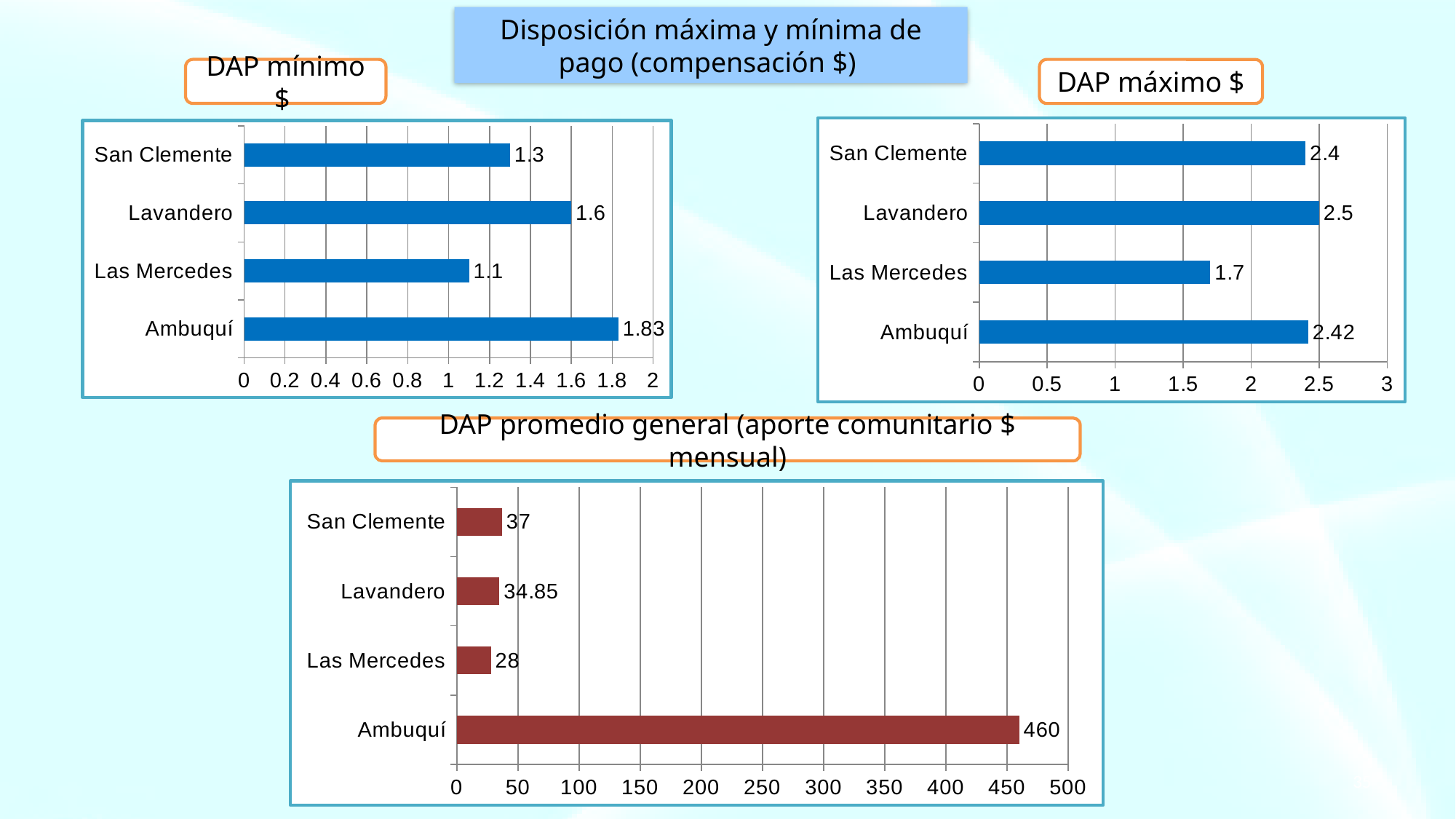
In the DAP promedio general chart, what is the value for Lavandero? 34.85 In the DAP máximo $ chart, what is the value for Las Mercedes? 1.7 In the DAP mínimo $ chart, which community has the lowest value? Las Mercedes In the DAP promedio general chart, which community has the highest value? Ambuquí In the DAP mínimo $ chart, what is the difference between Lavandero and San Clemente? 0.3 In the DAP máximo $ chart, which is larger, the value for San Clemente or the value for Ambuquí? Ambuquí In the DAP promedio general chart, what is the difference between Ambuquí and Las Mercedes? 432 What colour are the bars in the DAP promedio general chart? Dark red In the DAP máximo $ chart, which community has the highest value? Lavandero What kind of chart is the DAP promedio general chart? Bar chart In the DAP mínimo $ chart, what is the value for Ambuquí? 1.83 In the DAP máximo $ chart, how many communities are shown? 4